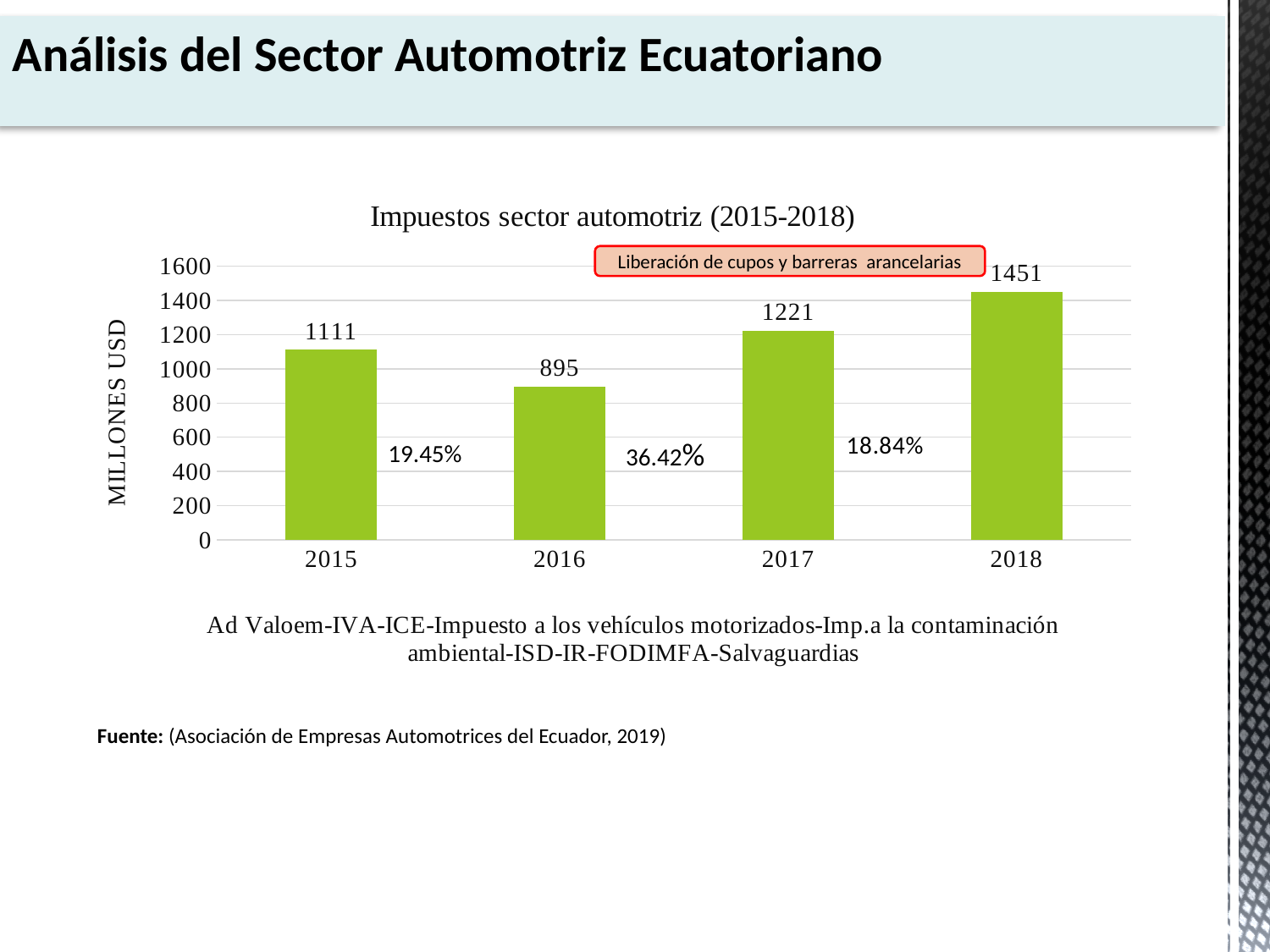
How many years are shown on the x axis? 4 Which is larger, the value for 2015 or the value for 2017? 2017 What kind of chart is this? Bar chart What is the value for 2016? 895 What is the title of the chart? Impuestos sector automotriz (2015-2018) Which year has the highest value? 2018 What is the value for 2017? 1221 What is the value for 2018? 1451 What is the difference between the values for 2018 and 2017? 230 Which year has the lowest value? 2016 What is the difference between the values for 2015 and 2016? 216 What is the value for 2015? 1111